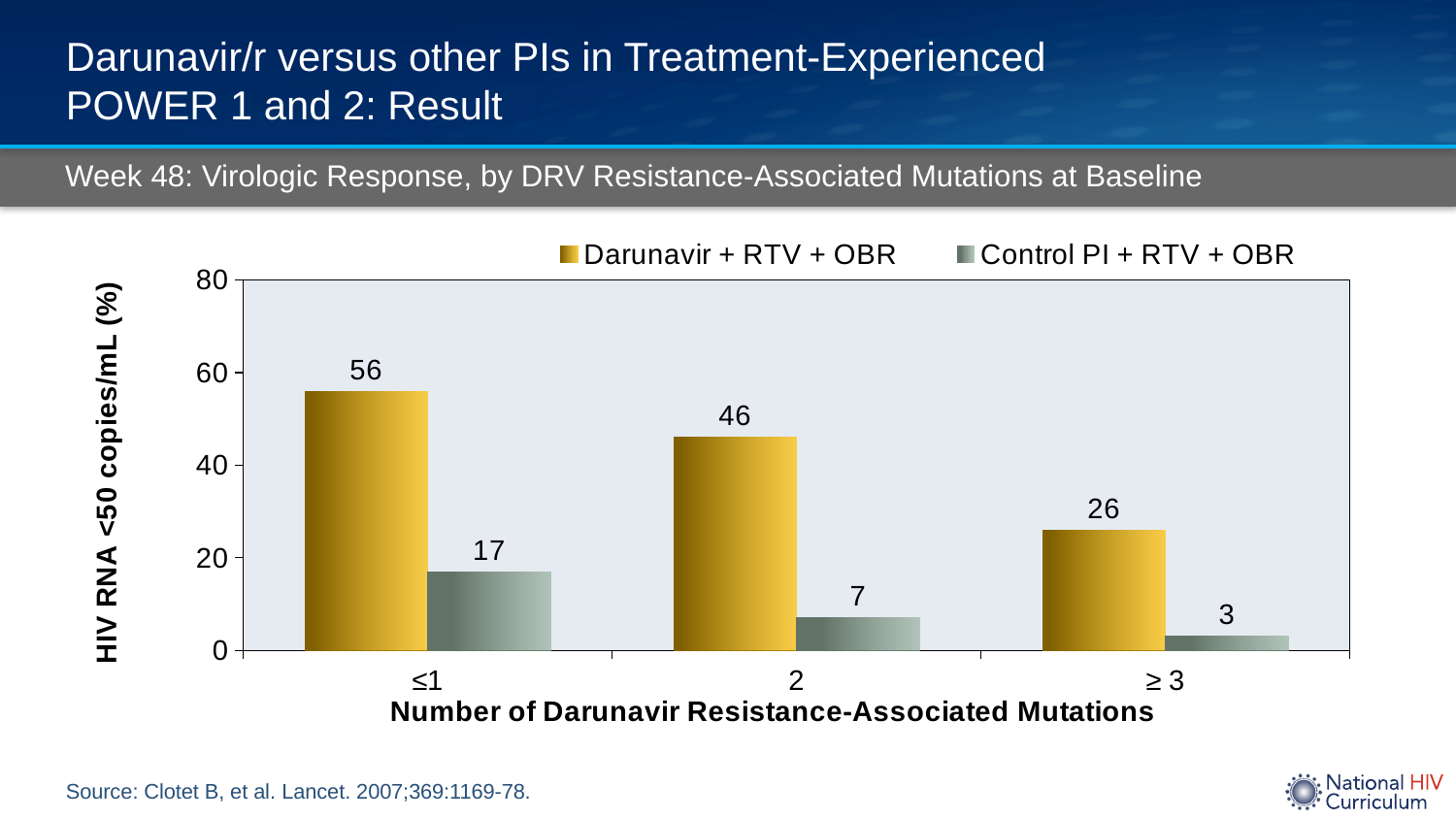
What is the value for Control PI + RTV + OBR in the ≥ 3 mutations category? 3 What kind of chart is shown on the slide? bar chart What is the difference between Darunavir + RTV + OBR and Control PI + RTV + OBR in the 2 mutations category? 39 How many categories are shown on the x axis? 3 Which is larger in the ≥ 3 mutations category: Darunavir + RTV + OBR or Control PI + RTV + OBR? Darunavir + RTV + OBR Which category has the lowest value for Control PI + RTV + OBR? ≥ 3 Is the value for Darunavir + RTV + OBR in the 2 mutations category greater or less than 40? greater What is the value for Darunavir + RTV + OBR in the ≤1 mutations category? 56 Do the values for Darunavir + RTV + OBR rise or fall as the number of mutations increases along the x axis? fall How many series does the legend list? 2 Which category has the highest value for Darunavir + RTV + OBR? ≤1 What is the value for Control PI + RTV + OBR in the 2 mutations category? 7